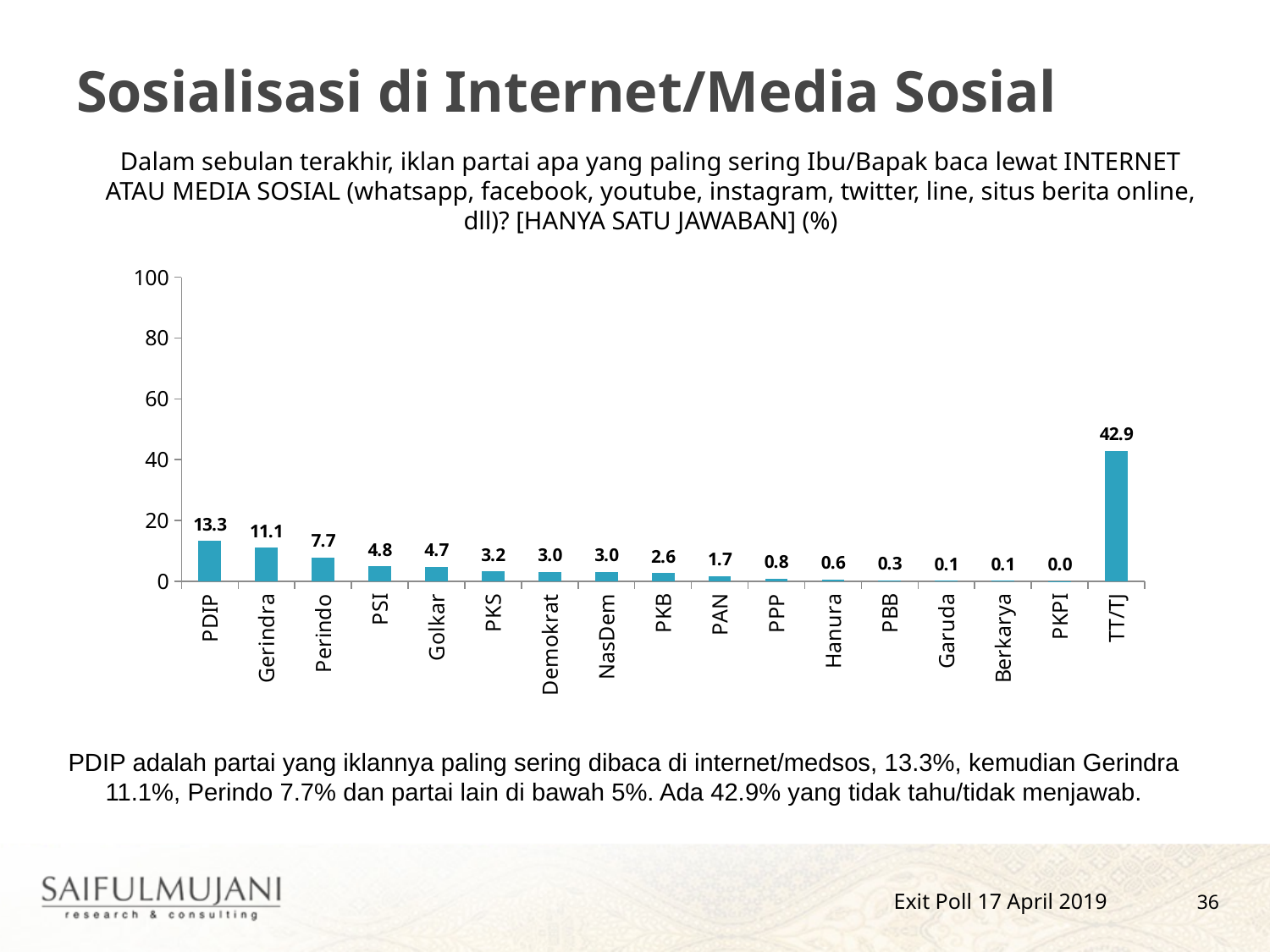
What is the value for Gerindra? 11.1 What is the value for PDIP? 13.3 How many categories are shown on the x axis? 17 Is the value for TT/TJ greater or less than 40? greater What is the value for TT/TJ? 42.9 Which category has the lowest value? PKPI What kind of chart is shown on the slide? bar chart What is the difference between the values for TT/TJ and PDIP? 29.6 Which is larger, the value for Perindo or the value for PSI? Perindo What is the difference between the values for PDIP and Gerindra? 2.2 What is the value for PKPI? 0.0 Which category has the highest value? TT/TJ